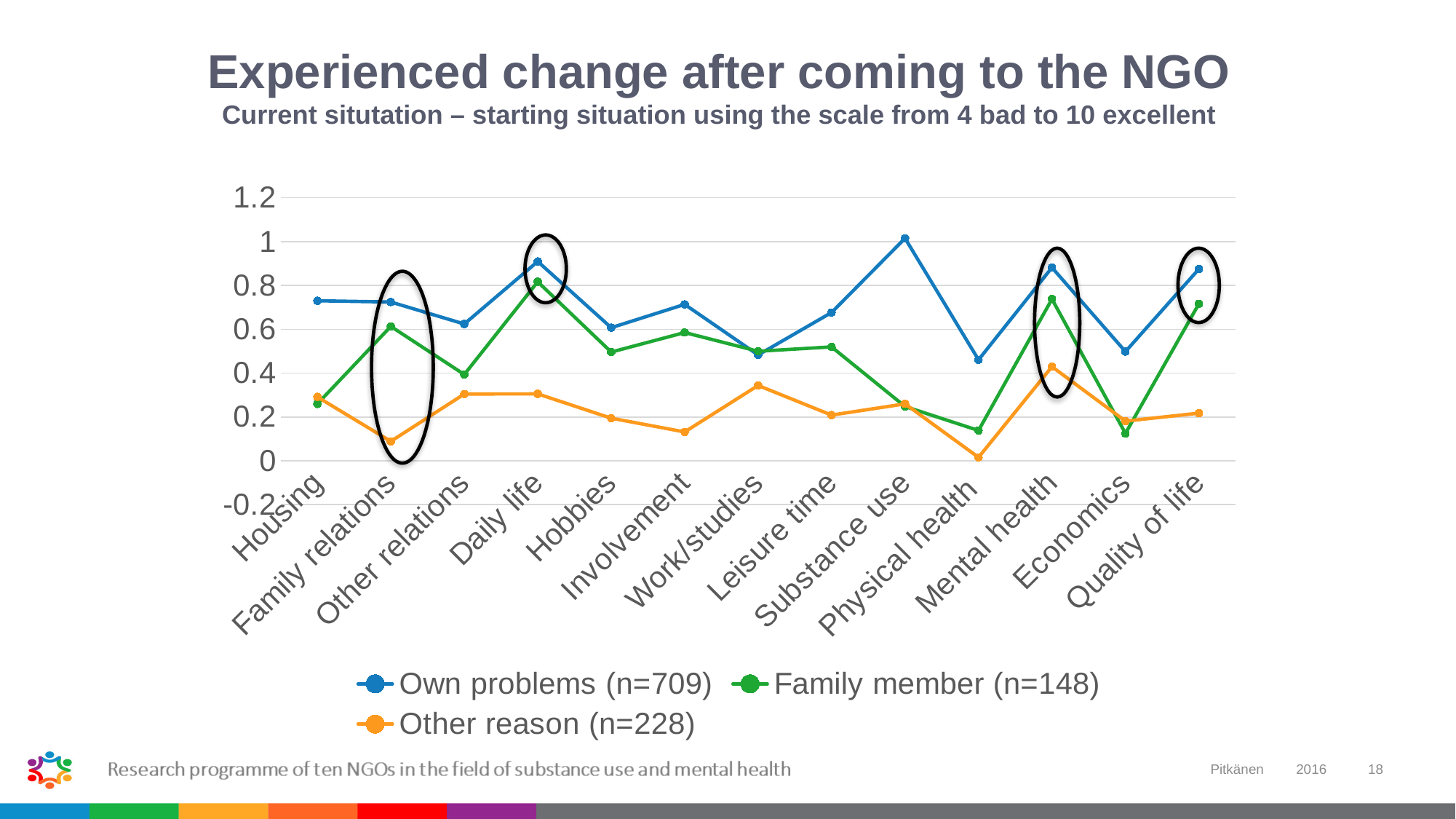
For which category is the Other reason (n=228) series highest? Mental health What kind of chart is shown on the slide? Line chart Does the Own problems (n=709) series rise or fall from Physical health to Mental health? rise How many series does the legend list? 3 For which category is the Family member (n=148) series highest? Daily life For which category is the Own problems (n=709) series highest? Substance use Is the Family member (n=148) value for Housing greater or less than 0.4? less For which category is the Other reason (n=228) series lowest? Physical health For Mental health, which series has the larger value: Family member (n=148) or Other reason (n=228)? Family member (n=148) Is the Own problems (n=709) value for Daily life greater or less than 0.8? greater For Family relations, which series has the larger value: Own problems (n=709) or Family member (n=148)? Own problems (n=709) How many categories are shown along the x axis? 13